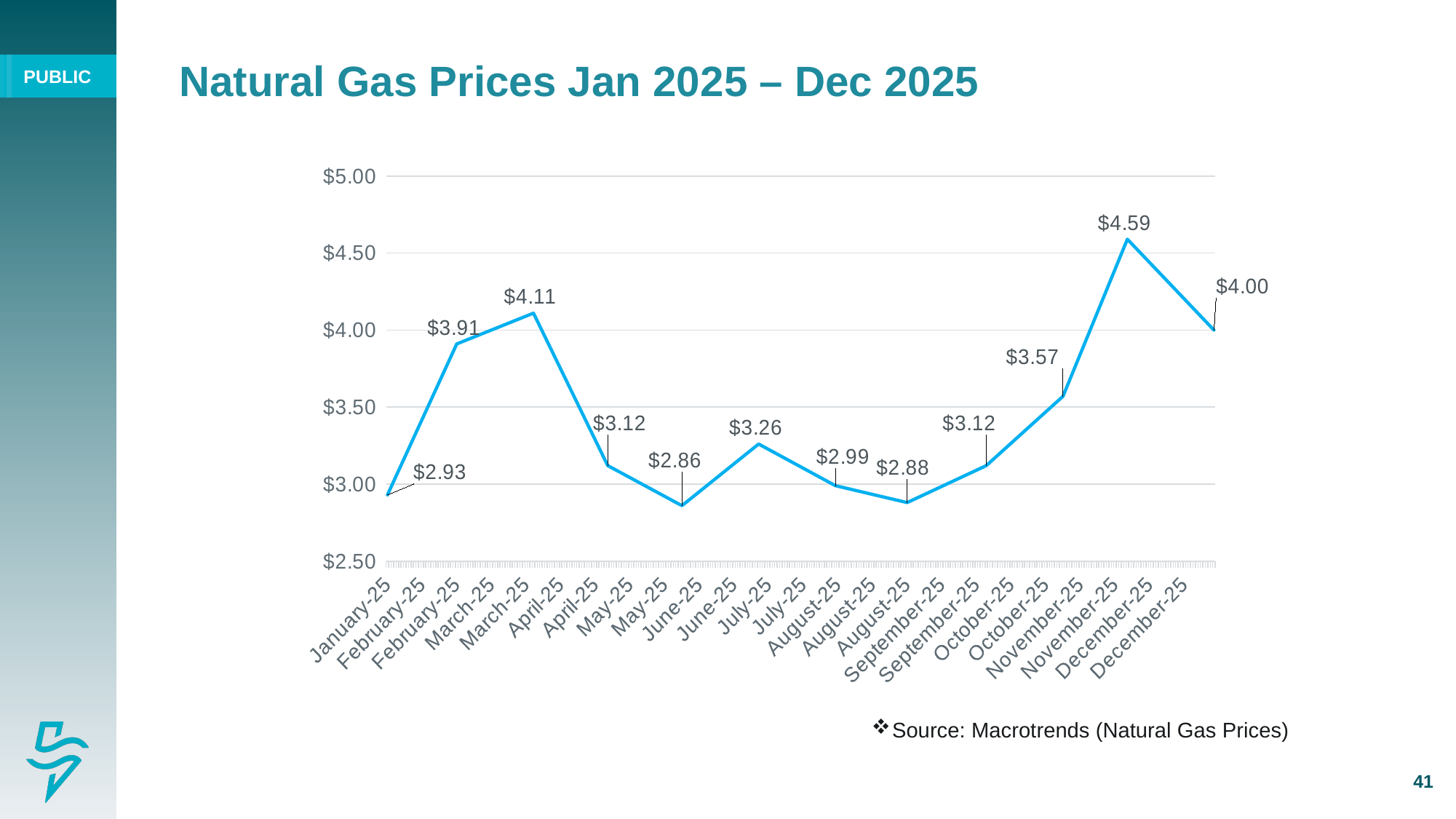
What is the title of the chart on the slide? Natural Gas Prices Jan 2025 – Dec 2025 What kind of chart is shown on the slide? Line chart What is the natural gas price for November-25? $4.59 What is the natural gas price for December-25? $4.00 Which month has the highest natural gas price? November-25 Which month has the lowest natural gas price? May-25 Is the value for October-25 greater or less than $3.50? greater Which is higher, the price for June-25 or the price for July-25? June-25 What is the difference between the November-25 price and the January-25 price? $1.66 What is the natural gas price for March-25? $4.11 What is the natural gas price for May-25? $2.86 What is the difference between the March-25 price and the April-25 price? $0.99